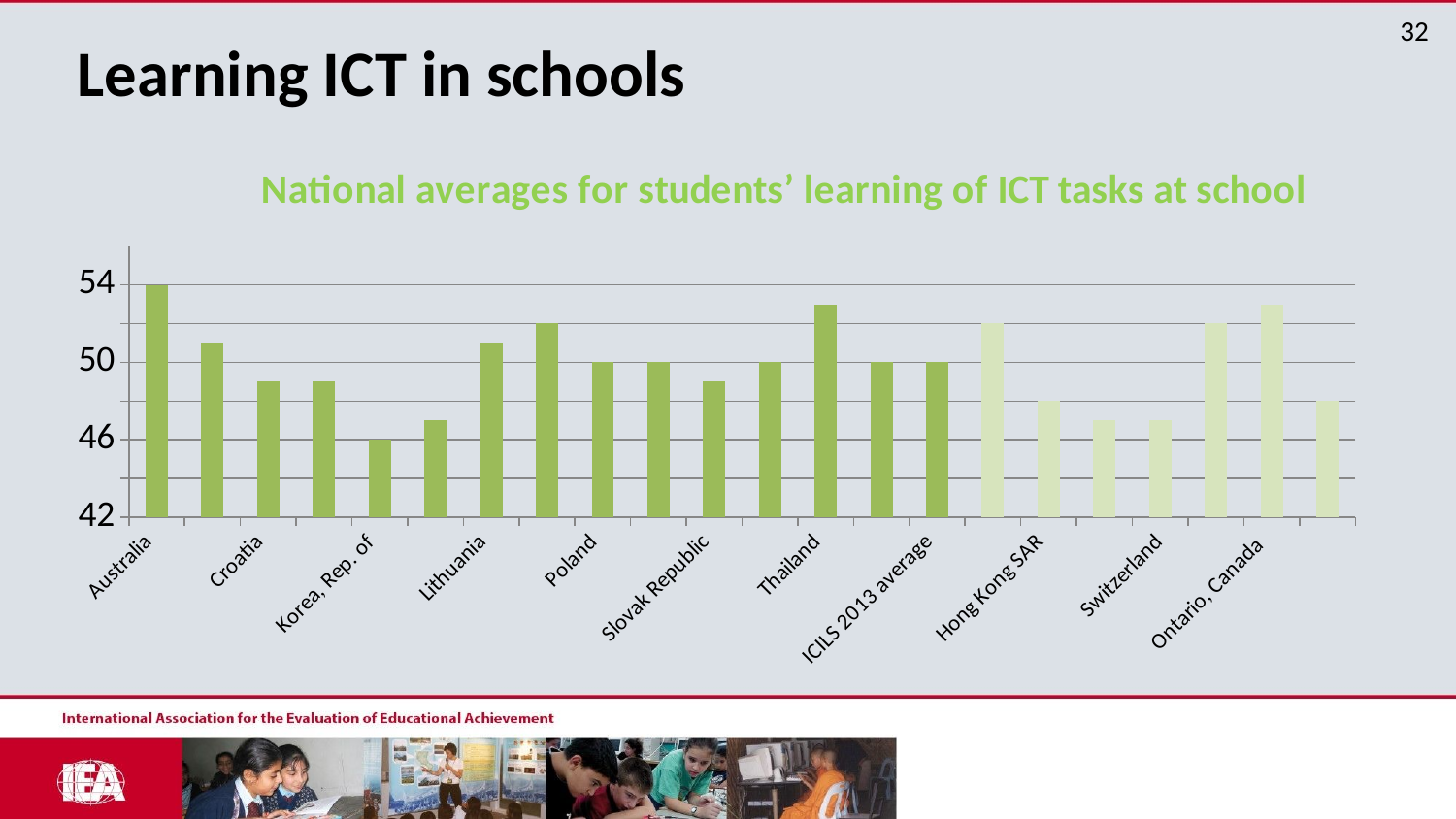
Is the value for Thailand greater or less than 50? greater What kind of chart is shown on the slide? bar chart What is the value for the ICILS 2013 average? 50 Is the value for Croatia greater or less than 50? less What is the value for Australia? 54 What is the value for Korea, Rep. of? 46 Is the value for Switzerland greater or less than 50? less Which country has the highest value in the chart? Australia What is the title of the chart? National averages for students' learning of ICT tasks at school Which is larger, the value for Lithuania or the value for Hong Kong SAR? Lithuania Which country has the lowest value in the chart? Korea, Rep. of